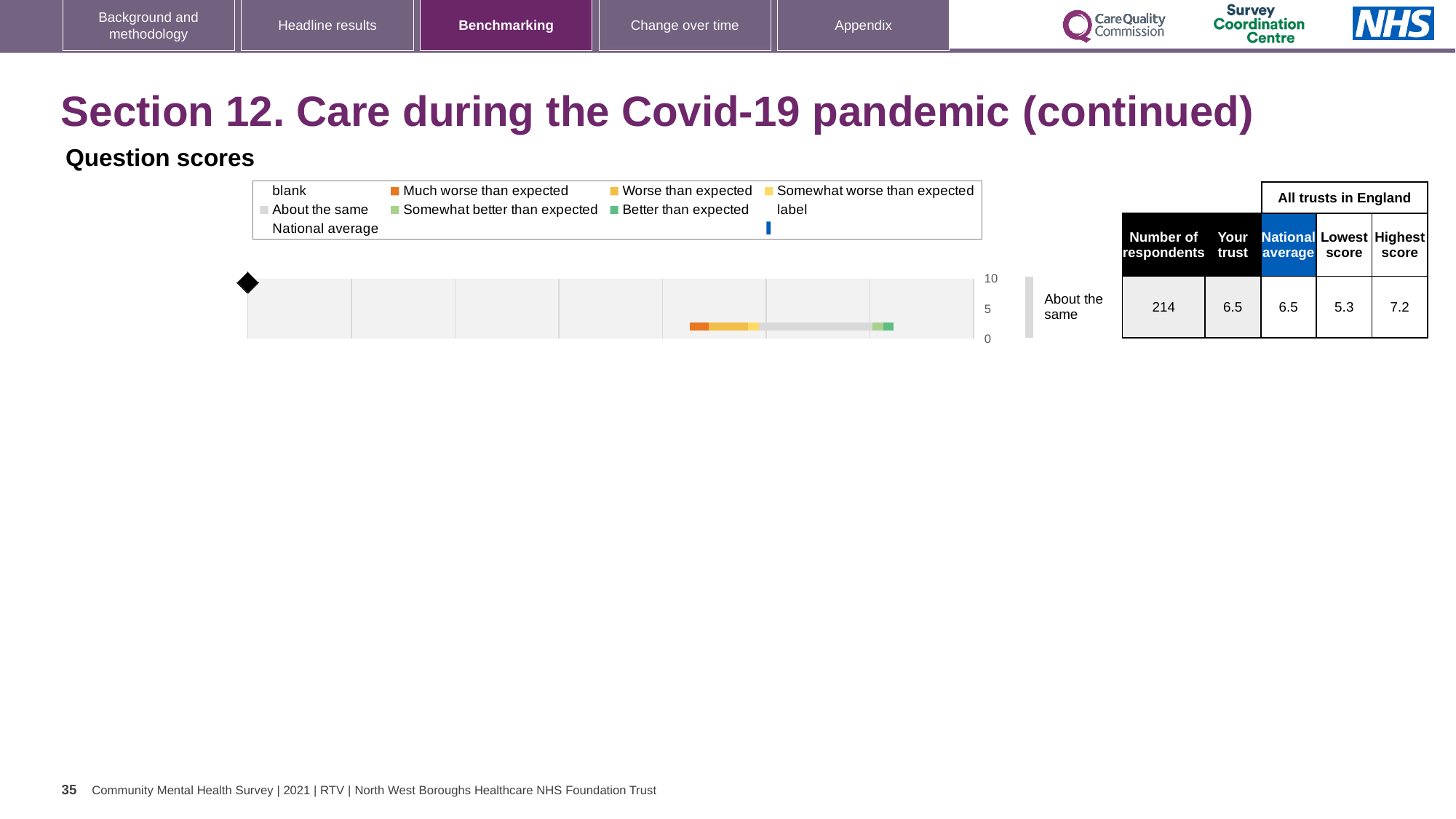
What is the maximum value shown on the chart's axis? 10 How many respondents are shown for this question? 214 What is the 'Your trust' score shown for the question in the Question scores chart? 6.5 What kind of chart is shown under 'Question scores'? bar chart What is the lowest score among all trusts in England for this question? 5.3 What is the difference between the highest score and the lowest score for this question? 1.9 What is the highest score among all trusts in England for this question? 7.2 Which colour does the legend use for 'Much worse than expected'? orange What is the difference between the highest score and the 'Your trust' score? 0.7 Which benchmark category is the trust's score placed in for this question? About the same Is the 'Your trust' score greater or less than 5 on the chart's axis? greater What is the national average score shown for the question in the Question scores chart? 6.5